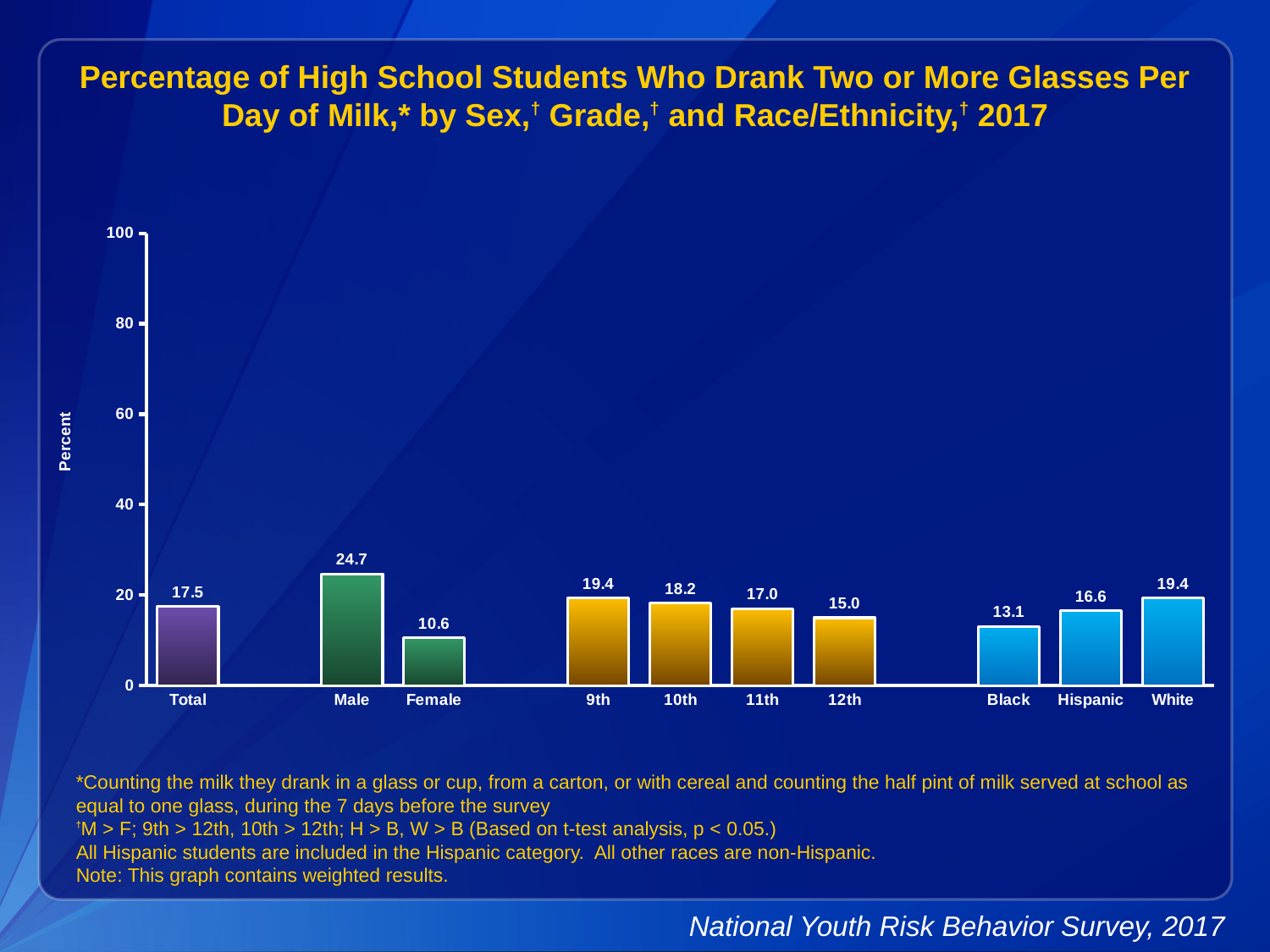
Do the values rise or fall from 9th grade to 12th grade? Fall What is the value for Hispanic students? 16.6 Which category has the highest value? Male Which is larger, the value for 9th grade or 11th grade? 9th What is the value for 12th grade? 15.0 What is the difference between the White and Black values? 6.3 What kind of chart is this? Bar chart Which category has the lowest value? Female What is the value for Female? 10.6 How many categories are shown on the x axis? 10 What is the value for Total? 17.5 What is the difference between the Male and Female values? 14.1